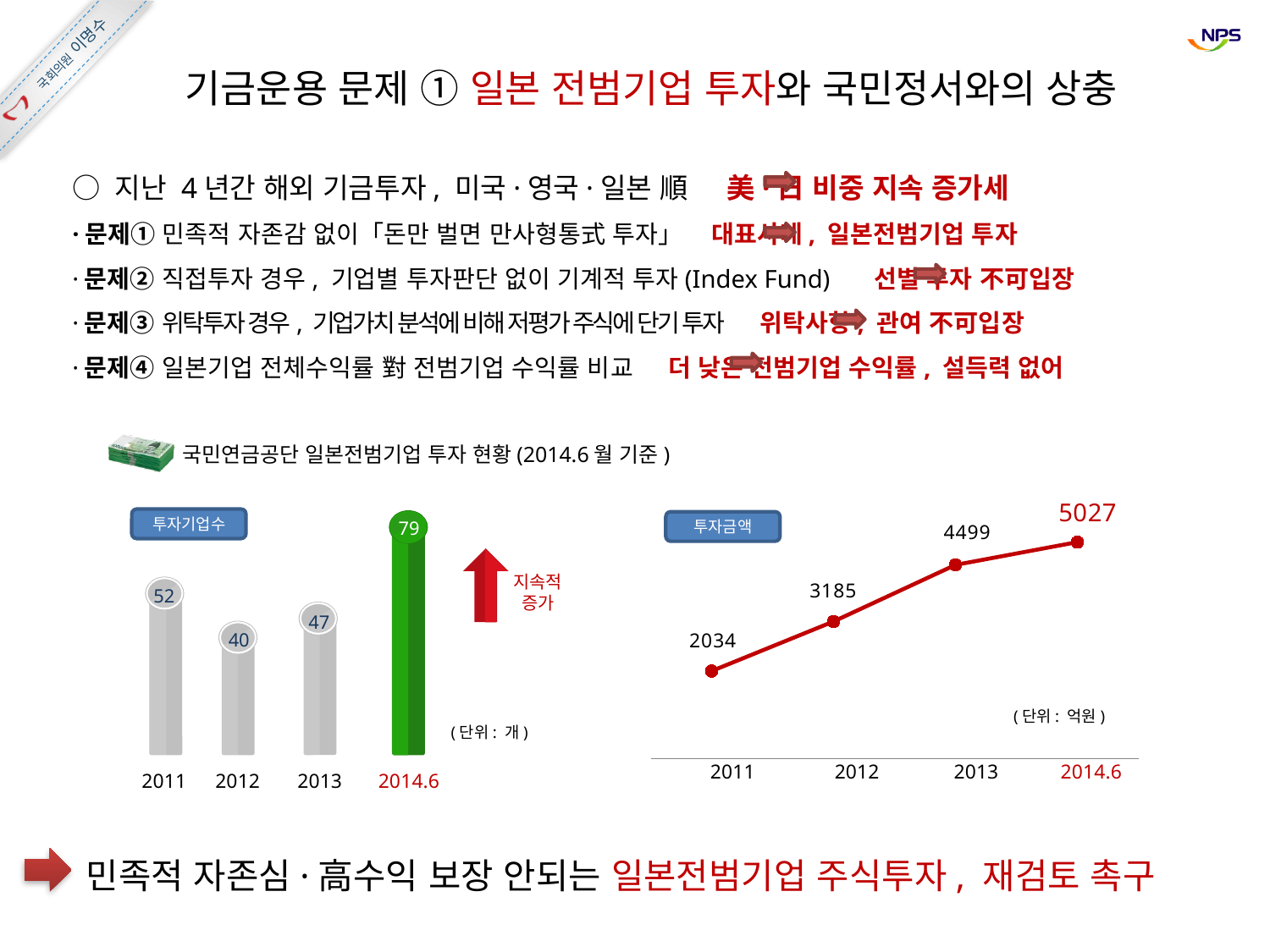
In the 투자기업수 chart on the left, what is the difference between the 2014.6 value and the 2013 value? 32 In the 투자기업수 chart on the left, which year has the highest value? 2014.6 In the 투자금액 chart on the right, what is the value for 2012? 3185 In the 투자기업수 chart on the left, how many categories are shown on the x axis? 4 In the 투자기업수 chart on the left, what is the value for 2014.6? 79 In the 투자금액 chart on the right, what is the value for 2014.6? 5027 What kind of chart is the 투자기업수 chart on the left? bar chart In the 투자기업수 chart on the left, what is the value for 2011? 52 In the 투자금액 chart on the right, what is the difference between the 2013 value and the 2011 value? 2465 What unit is shown for the 투자금액 chart on the right? 억원 In the 투자금액 chart on the right, do the values rise or fall from 2011 to 2014.6? rise In the 투자기업수 chart on the left, which year has the lowest value? 2012